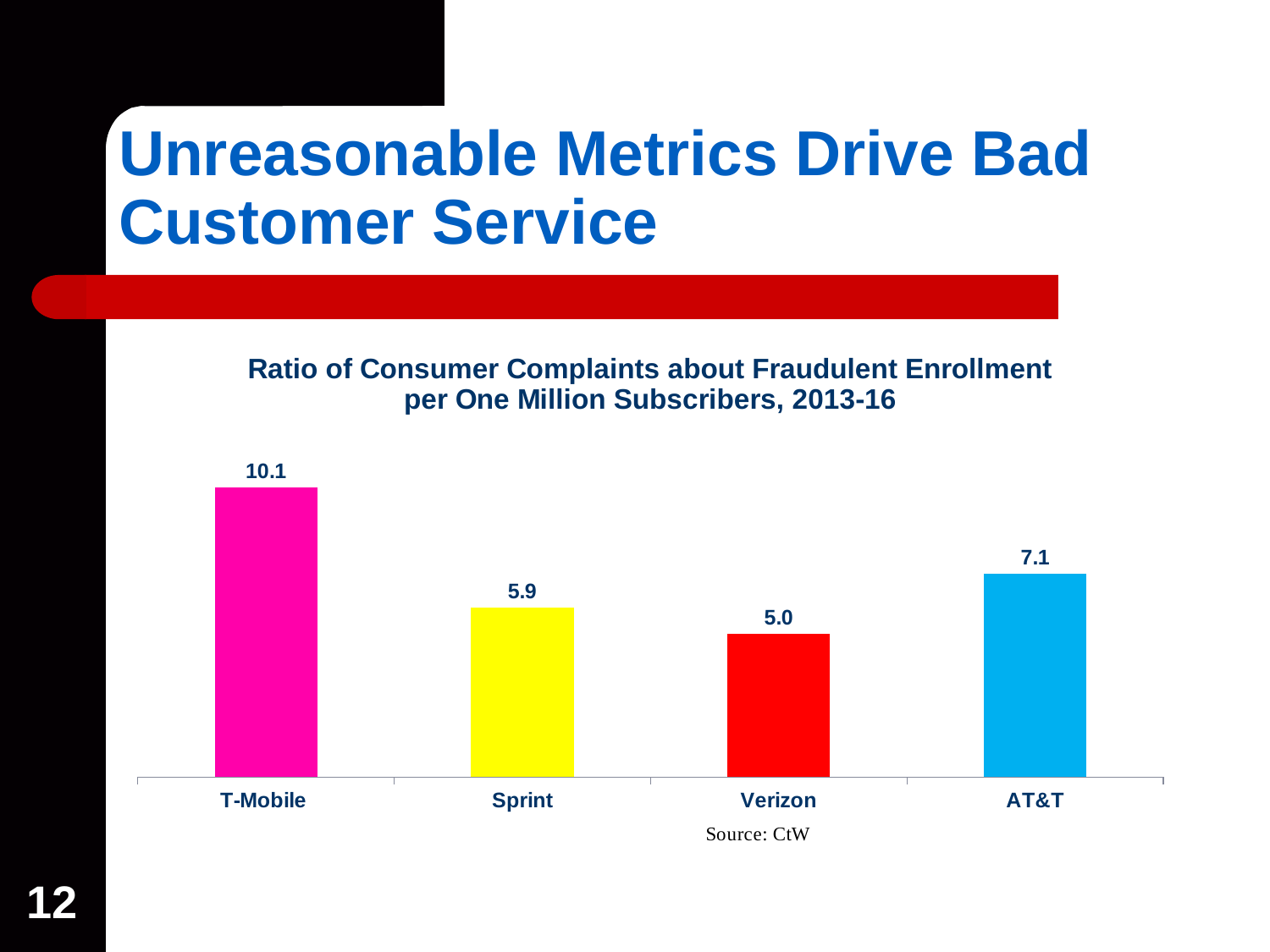
Which carrier has the highest ratio of complaints? T-Mobile What is the value for T-Mobile? 10.1 How many carriers are shown in the chart? 4 What is the difference between the values for Sprint and Verizon? 0.9 What is the title of the chart? Ratio of Consumer Complaints about Fraudulent Enrollment per One Million Subscribers, 2013-16 What kind of chart is shown on the slide? Bar chart What is the value for AT&T? 7.1 Which is larger, the value for AT&T or the value for Sprint? AT&T What is the value for Verizon? 5.0 What is the difference between the values for T-Mobile and AT&T? 3.0 What is the value for Sprint? 5.9 Which carrier has the lowest ratio of complaints? Verizon